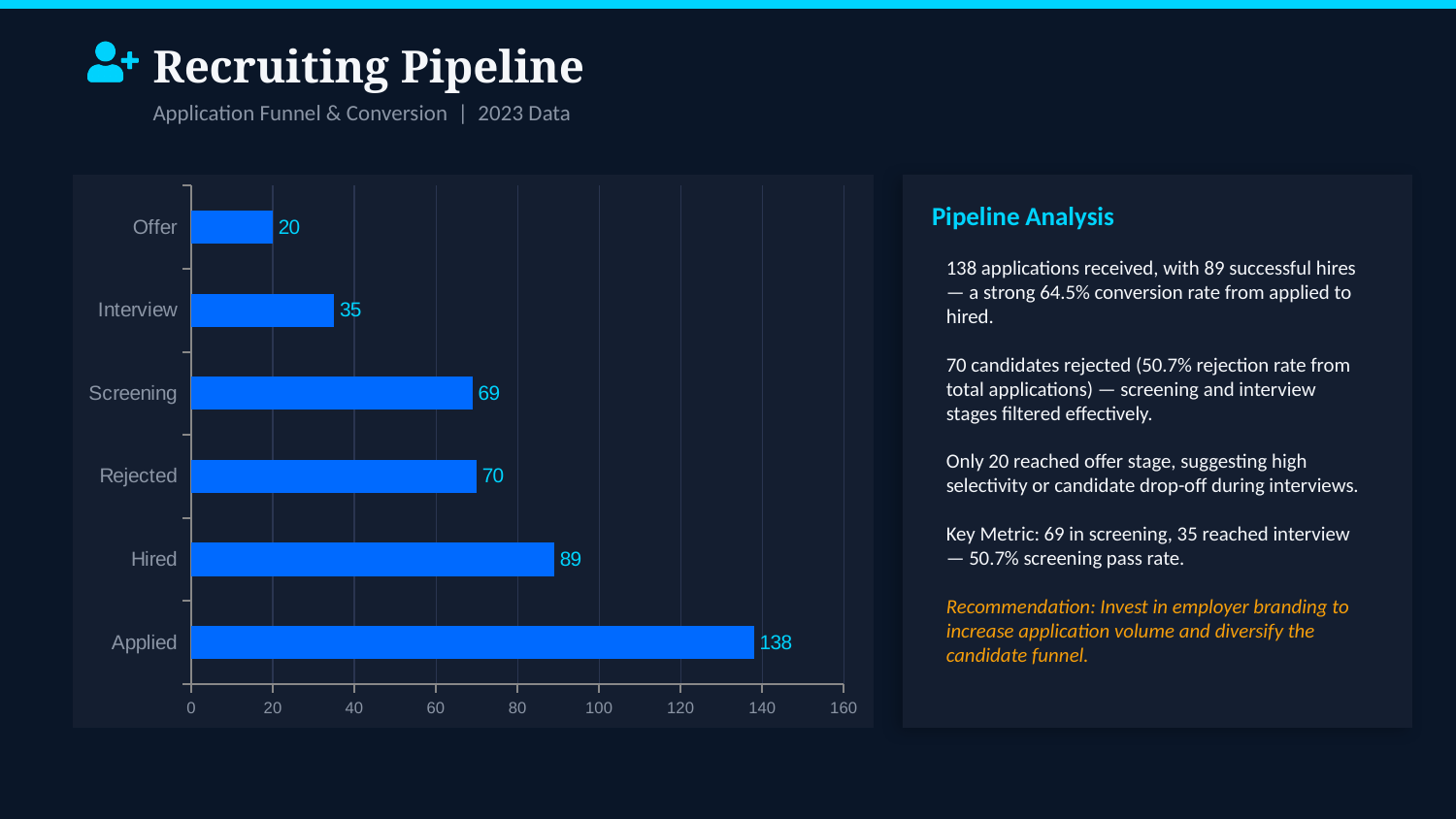
How many categories are shown in the chart? 6 What is the value for Screening? 69 What is the difference between the values for Applied and Hired? 49 What kind of chart is shown on the slide? bar chart What is the difference between the values for Interview and Offer? 15 What is the value for Applied? 138 Which is larger, the value for Hired or the value for Rejected? Hired What is the value for Offer? 20 Is the value for Hired greater or less than 80? greater Which category has the highest value? Applied What is the maximum value shown on the horizontal axis? 160 Which category has the lowest value? Offer